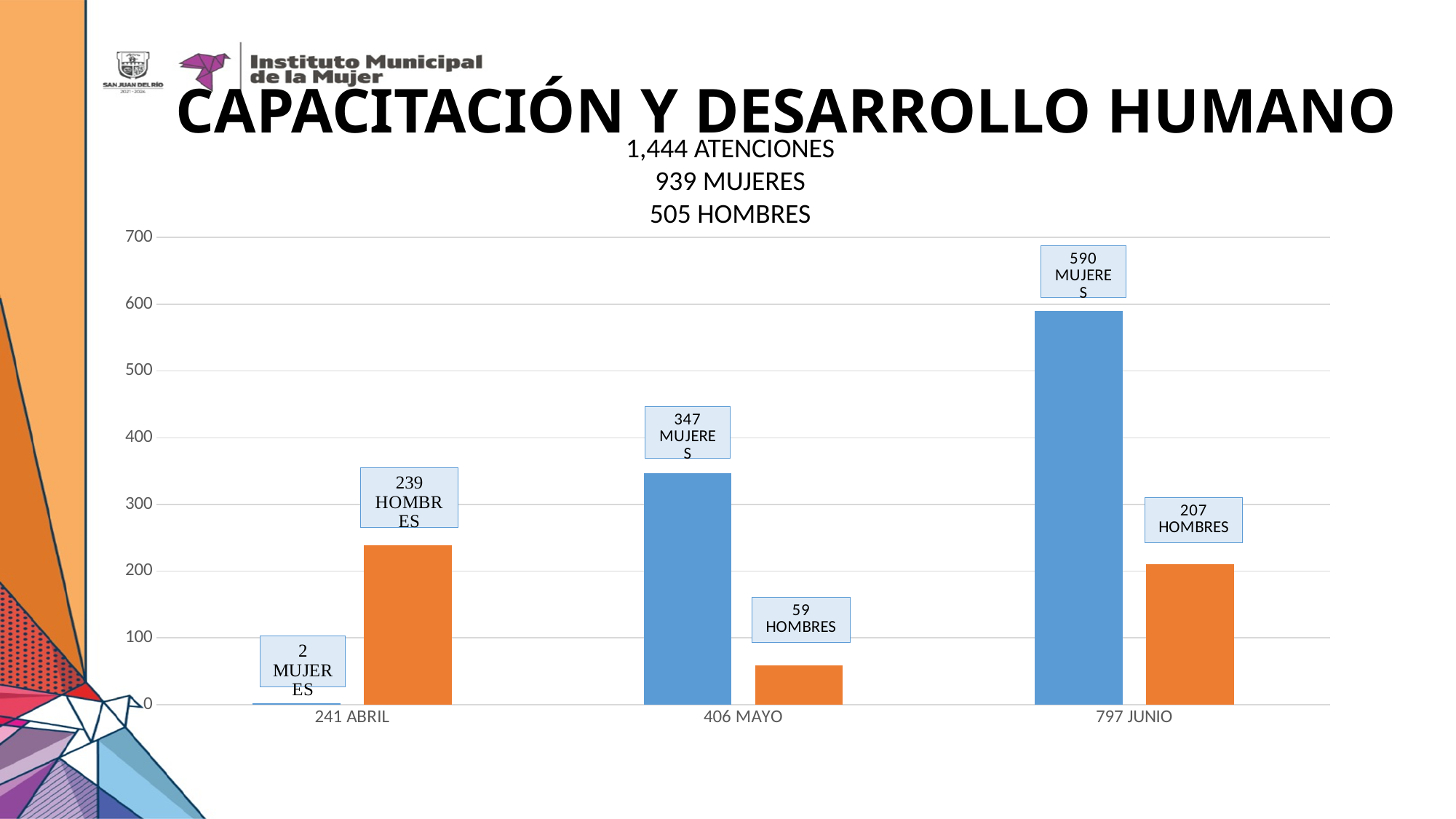
What is the value of the HOMBRES bar for 241 ABRIL? 239 Which is larger for 241 ABRIL, the MUJERES value or the HOMBRES value? HOMBRES What is the value of the MUJERES bar for 406 MAYO? 347 How many categories are shown on the x axis of the chart? 3 What colour are the MUJERES bars in the chart? blue Which category has the lowest HOMBRES value? 406 MAYO What is the value of the MUJERES bar for 797 JUNIO? 590 What is the difference between the MUJERES and HOMBRES values for 797 JUNIO? 383 Do the MUJERES values rise or fall from 241 ABRIL to 797 JUNIO? rise What kind of chart is shown on the slide? bar chart Which category has the highest MUJERES value? 797 JUNIO What is the value of the HOMBRES bar for 406 MAYO? 59